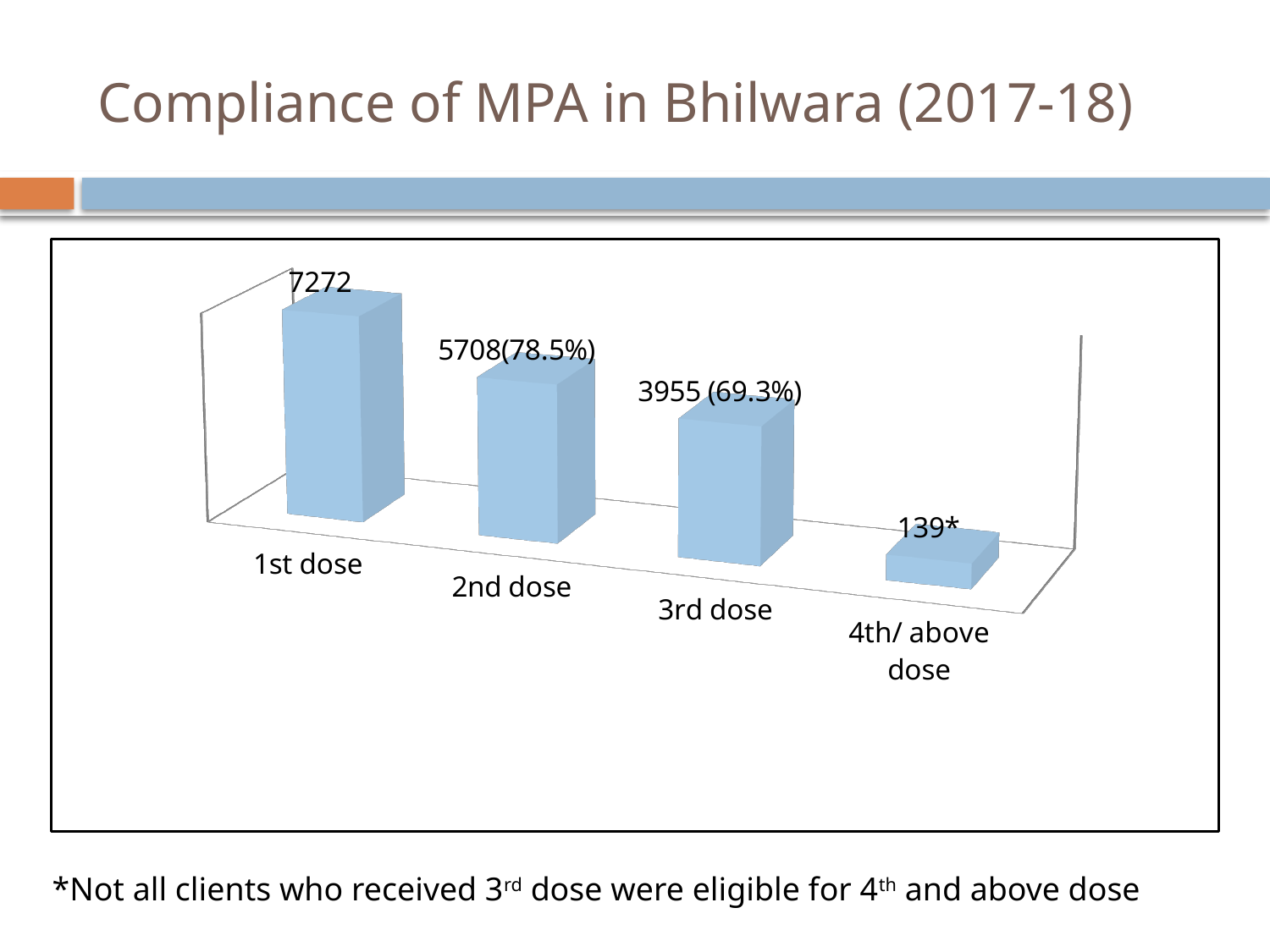
What is the data label shown for 2nd dose? 5708(78.5%) Which dose category has the lowest value? 4th/ above dose What is the value shown for 1st dose? 7272 What is the difference between the 1st dose and 2nd dose values? 1564 What kind of chart is shown on the slide? Bar chart How many dose categories are shown in the chart? 4 Do the values rise or fall from 1st dose to 4th/ above dose? Fall Which is larger, the value for 2nd dose or the value for 3rd dose? 2nd dose What is the difference between the 2nd dose and 3rd dose values? 1753 Which dose category has the highest value? 1st dose What is the data label shown for 4th/ above dose? 139* What is the data label shown for 3rd dose? 3955 (69.3%)